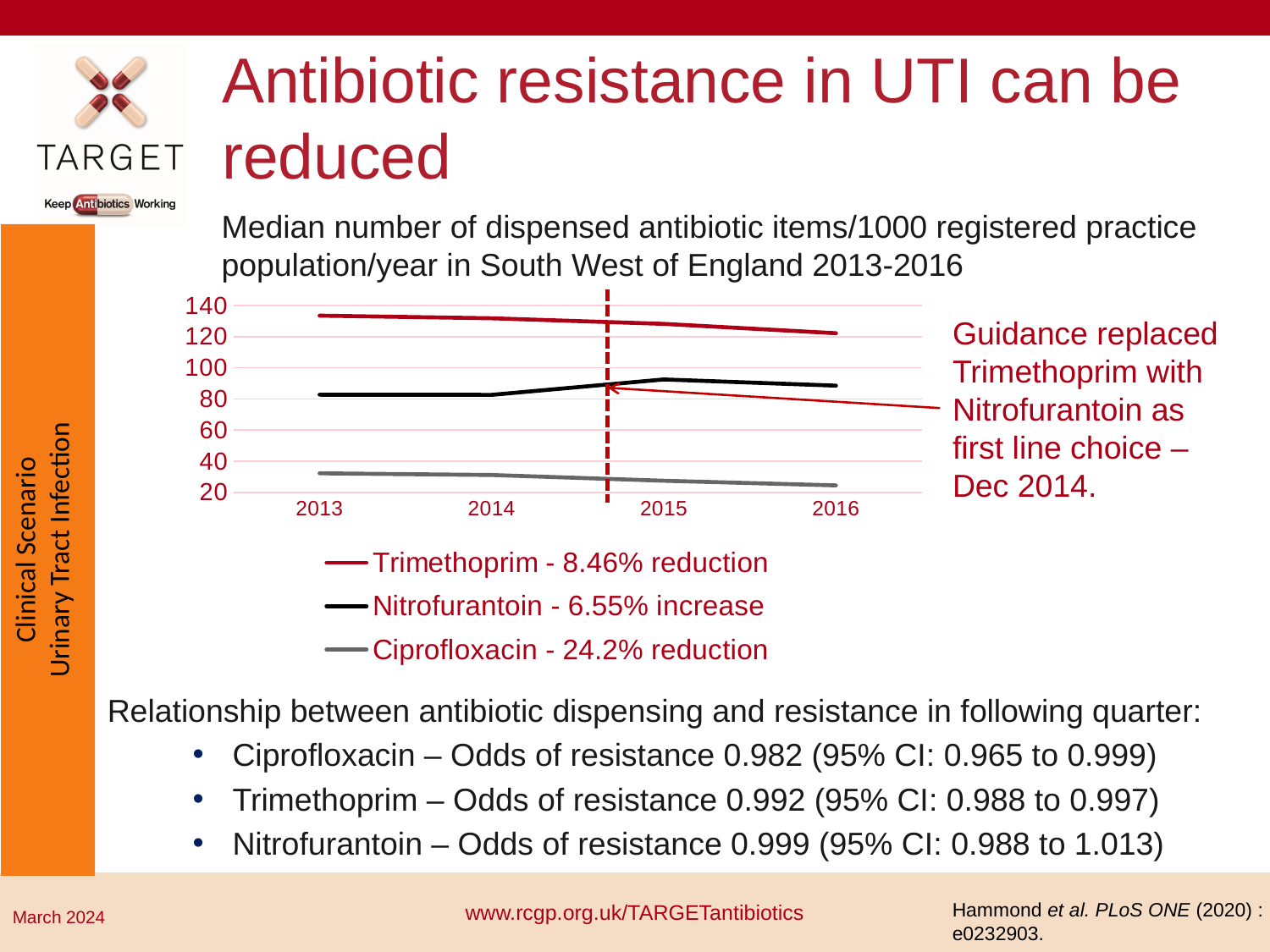
How many series does the chart legend list? 3 Which series has the lowest value in 2013? Ciprofloxacin How many years are shown along the x axis of the chart? 4 What kind of chart is shown on the slide? line chart Does the Nitrofurantoin line rise or fall from 2013 to 2016? rise Which series has the highest value in 2016? Trimethoprim Is the value for Ciprofloxacin in 2016 greater or less than 40? less Is the value for Trimethoprim in 2013 greater or less than 120? greater Does the Trimethoprim line rise or fall from 2013 to 2016? fall Is the value for Nitrofurantoin in 2013 greater or less than 100? less Which is larger, the Nitrofurantoin value in 2014 or in 2015? 2015 What percentage reduction does the legend give for Ciprofloxacin? 24.2%